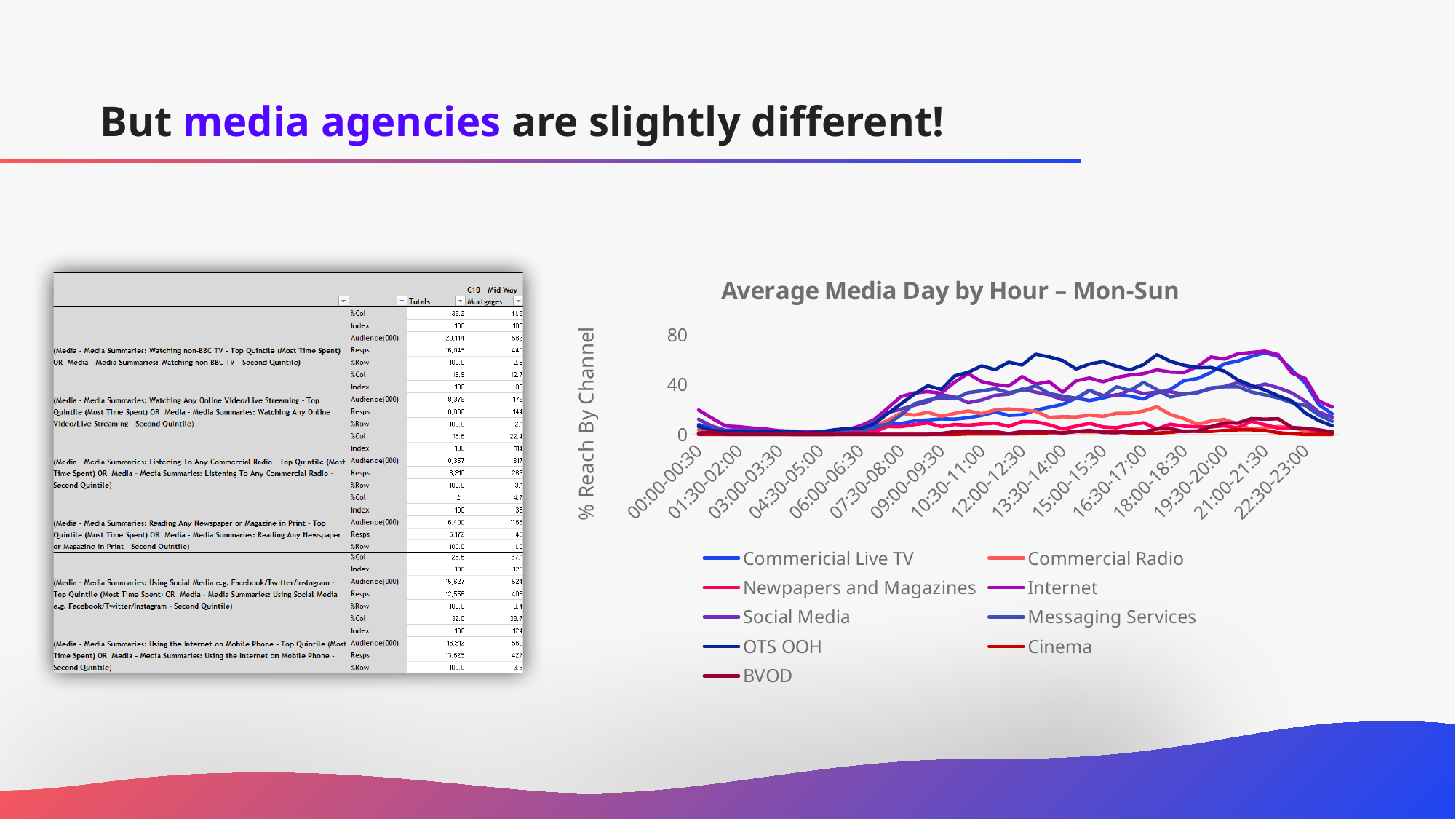
In the 'Average Media Day by Hour – Mon-Sun' chart, is the value for Commercial Radio at 03:00-03:30 greater or less than 40? less What is the title of the chart on the right of the slide? Average Media Day by Hour – Mon-Sun How many series does the legend of the 'Average Media Day by Hour – Mon-Sun' chart list? 9 In the 'Average Media Day by Hour – Mon-Sun' chart, is the value for Cinema at 12:00-12:30 greater or less than 40? less In the 'Average Media Day by Hour – Mon-Sun' chart, is the value for Commercial Live TV at 21:00-21:30 greater or less than 40? greater In the 'Average Media Day by Hour – Mon-Sun' chart, which is larger at 12:00-12:30: OTS OOH or Cinema? OTS OOH What is the y-axis label of the 'Average Media Day by Hour – Mon-Sun' chart? % Reach By Channel In the 'Average Media Day by Hour – Mon-Sun' chart, does Commercial Live TV rise or fall between 06:00-06:30 and 21:00-21:30? rise What kind of chart is 'Average Media Day by Hour – Mon-Sun'? line chart In the 'Average Media Day by Hour – Mon-Sun' chart, which series stays lowest across the whole day? Cinema How many time-slot labels are shown on the x axis of the 'Average Media Day by Hour – Mon-Sun' chart? 16